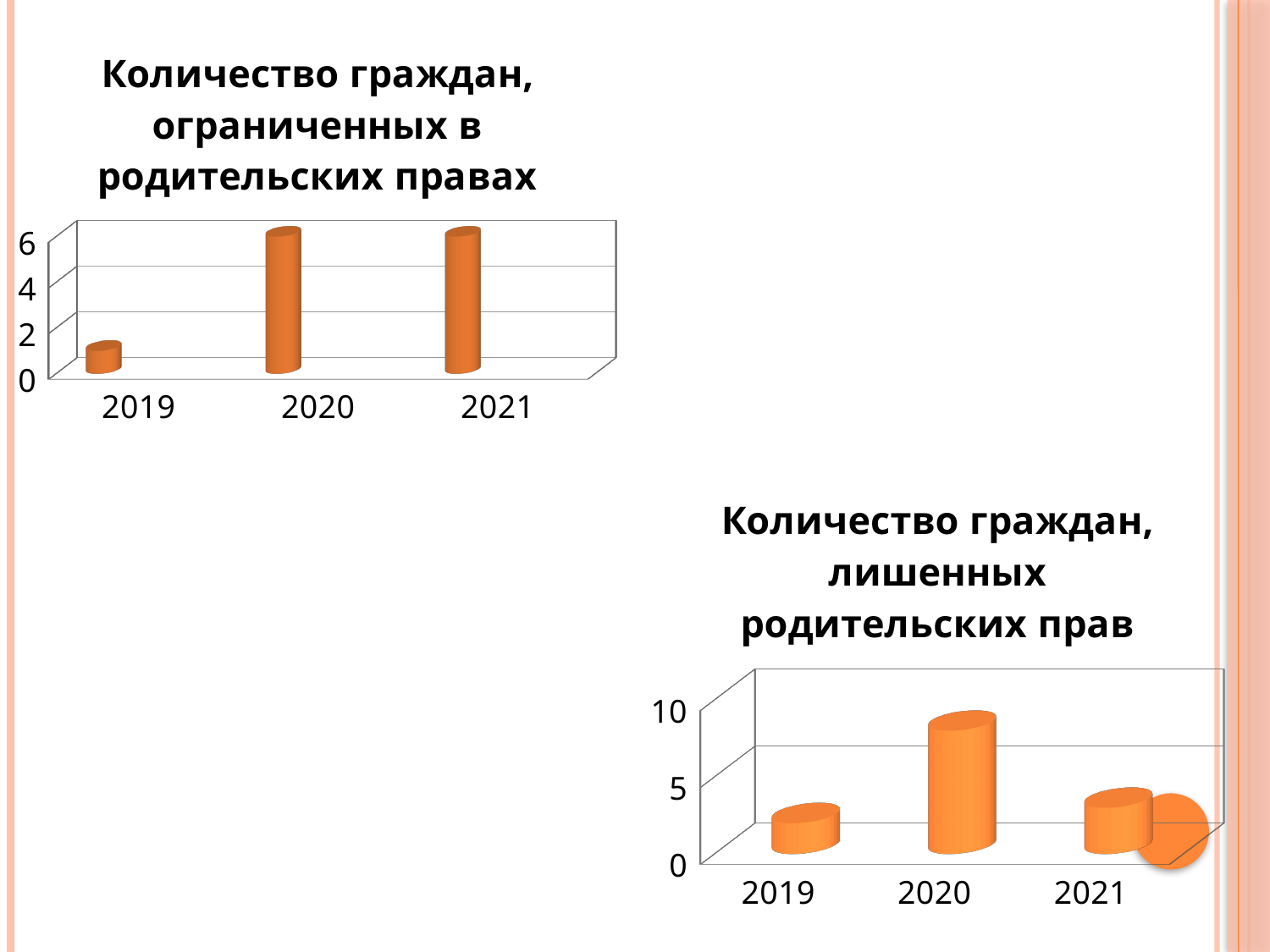
In the top chart ("Количество граждан, ограниченных в родительских правах"), does the value rise or fall from 2019 to 2020? rise In the bottom chart ("Количество граждан, лишенных родительских прав"), which year has the highest value? 2020 In the top chart ("Количество граждан, ограниченных в родительских правах"), which year has the lowest value? 2019 In the top chart ("Количество граждан, ограниченных в родительских правах"), is the value for 2019 greater or less than 2? less In the bottom chart ("Количество граждан, лишенных родительских прав"), is the value for 2020 greater or less than 5? greater In the top chart ("Количество граждан, ограниченных в родительских правах"), which is larger, the value for 2019 or the value for 2021? 2021 What kind of chart is the top chart titled "Количество граждан, ограниченных в родительских правах"? bar chart In the bottom chart ("Количество граждан, лишенных родительских прав"), is the value for 2021 greater or less than 5? less What is the title of the bottom chart on the slide? Количество граждан, лишенных родительских прав In the bottom chart ("Количество граждан, лишенных родительских прав"), does the value rise or fall from 2020 to 2021? fall In the top chart ("Количество граждан, ограниченных в родительских правах"), how many years are shown on the x axis? 3